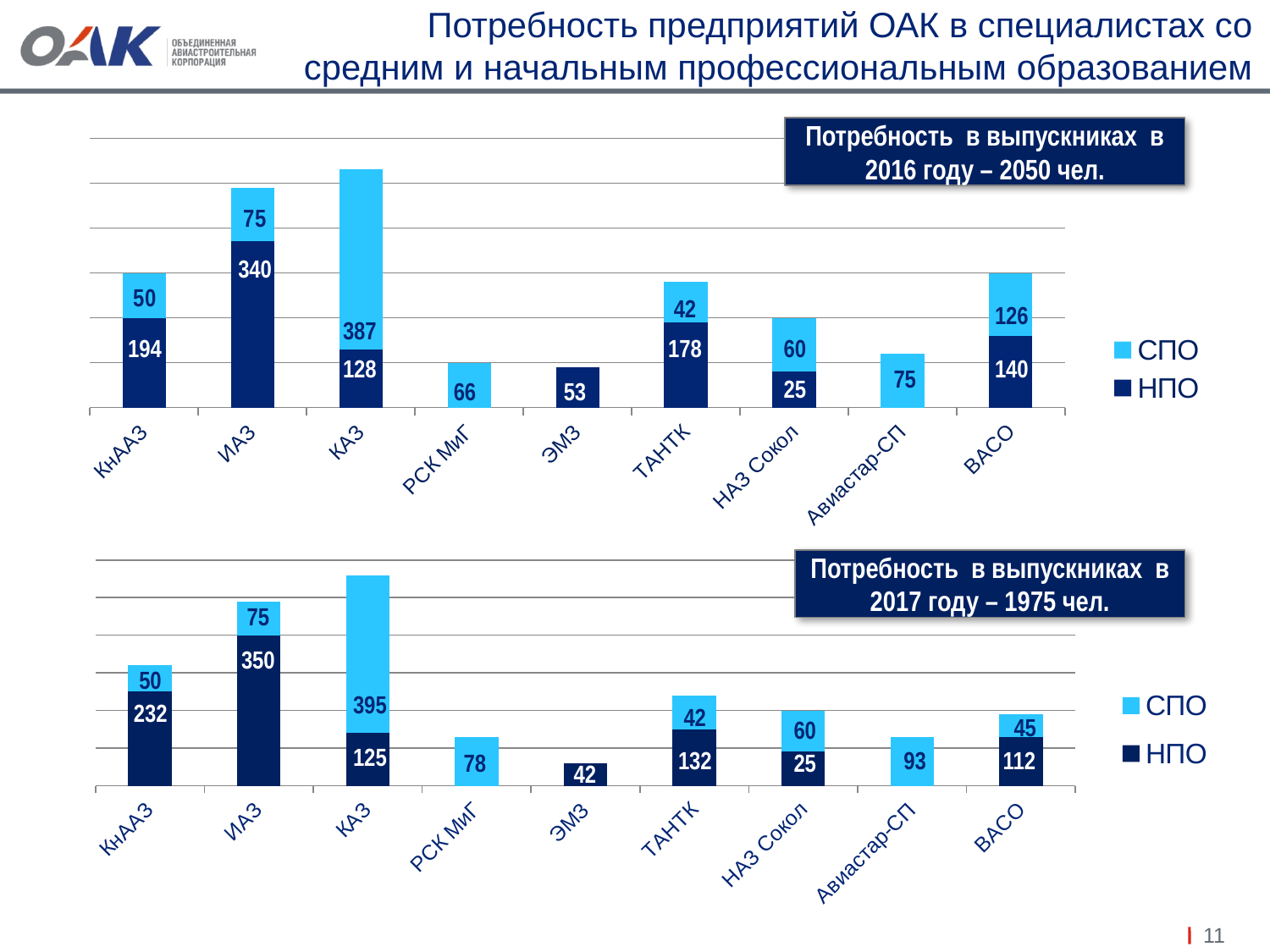
In the top chart, what is the difference between the НПО values for ИАЗ and КнААЗ? 146 In the bottom chart, what is the НПО value for ИАЗ? 350 In the bottom chart, which is larger: the НПО value for ТАНТК or the НПО value for ВАСО? ТАНТК In the top chart, what is the СПО value for КАЗ? 387 In the bottom chart, which category has the shortest stacked bar? ЭМЗ How many categories are shown on the x axis of the top chart? 9 What type of chart is the bottom chart? Stacked bar chart In the top chart, what is the total of the stacked bar for ВАСО? 266 In the top chart, what is the НПО value for КнААЗ? 194 In the bottom chart, what is the СПО value for Авиастар-СП? 93 In the bottom chart, what is the total of the stacked bar for КАЗ? 520 In the top chart, which category has the tallest stacked bar? КАЗ